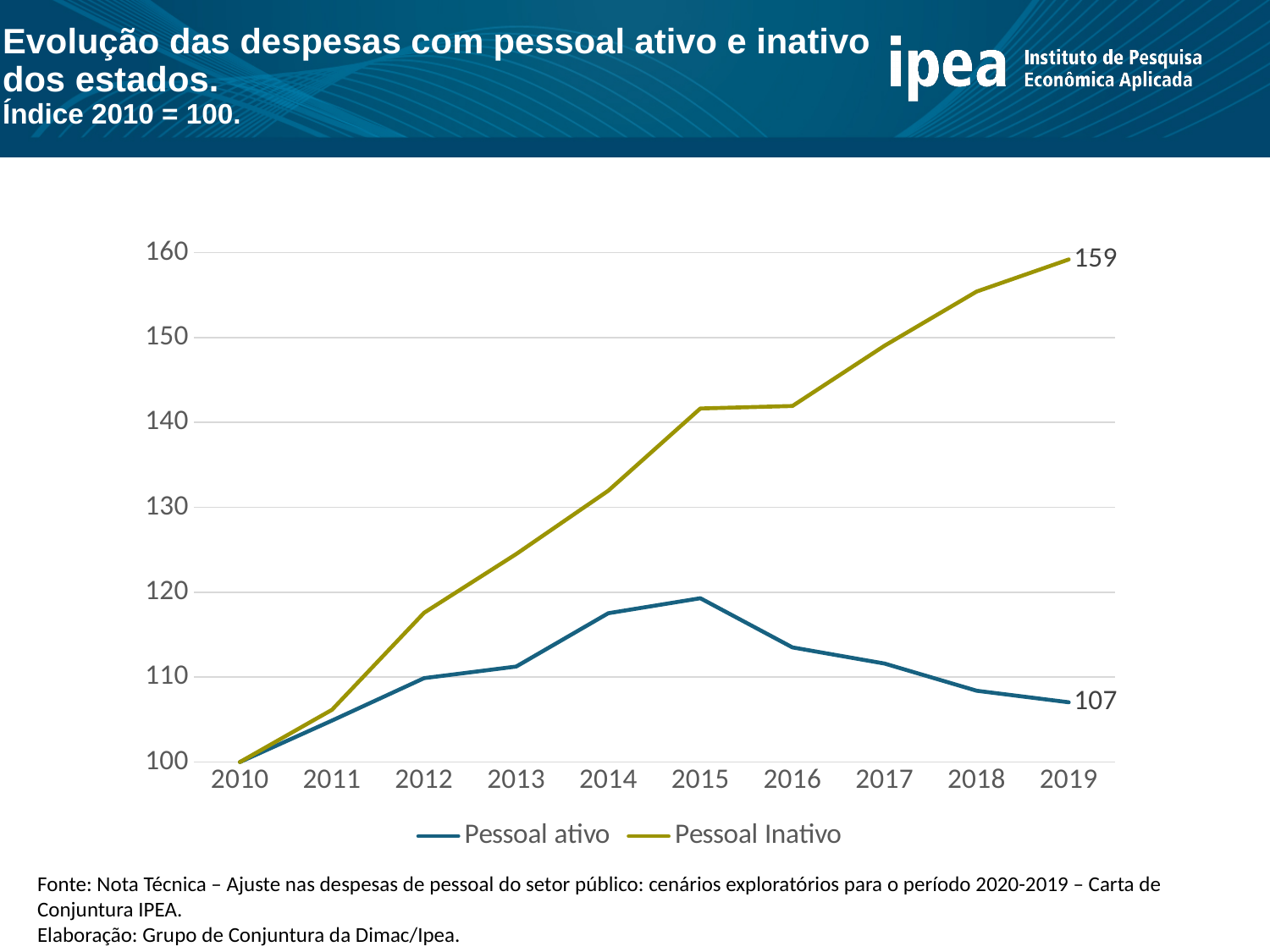
Does the Pessoal Inativo series rise or fall from 2010 to 2019? rises What is the difference between the Pessoal Inativo and Pessoal ativo values in 2019? 52 What is the value for Pessoal Inativo in 2019? 159 Is the value for Pessoal ativo in 2015 greater or less than 110? greater In which year does the Pessoal ativo series reach its highest value? 2015 How many series does the legend list? 2 Is the value for Pessoal Inativo in 2018 greater or less than 150? greater Which series has the higher value in 2019, Pessoal ativo or Pessoal Inativo? Pessoal Inativo What is the value of both series in 2010? 100 What kind of chart is shown on the slide? line chart How many years are shown on the x axis? 10 What is the value for Pessoal ativo in 2019? 107